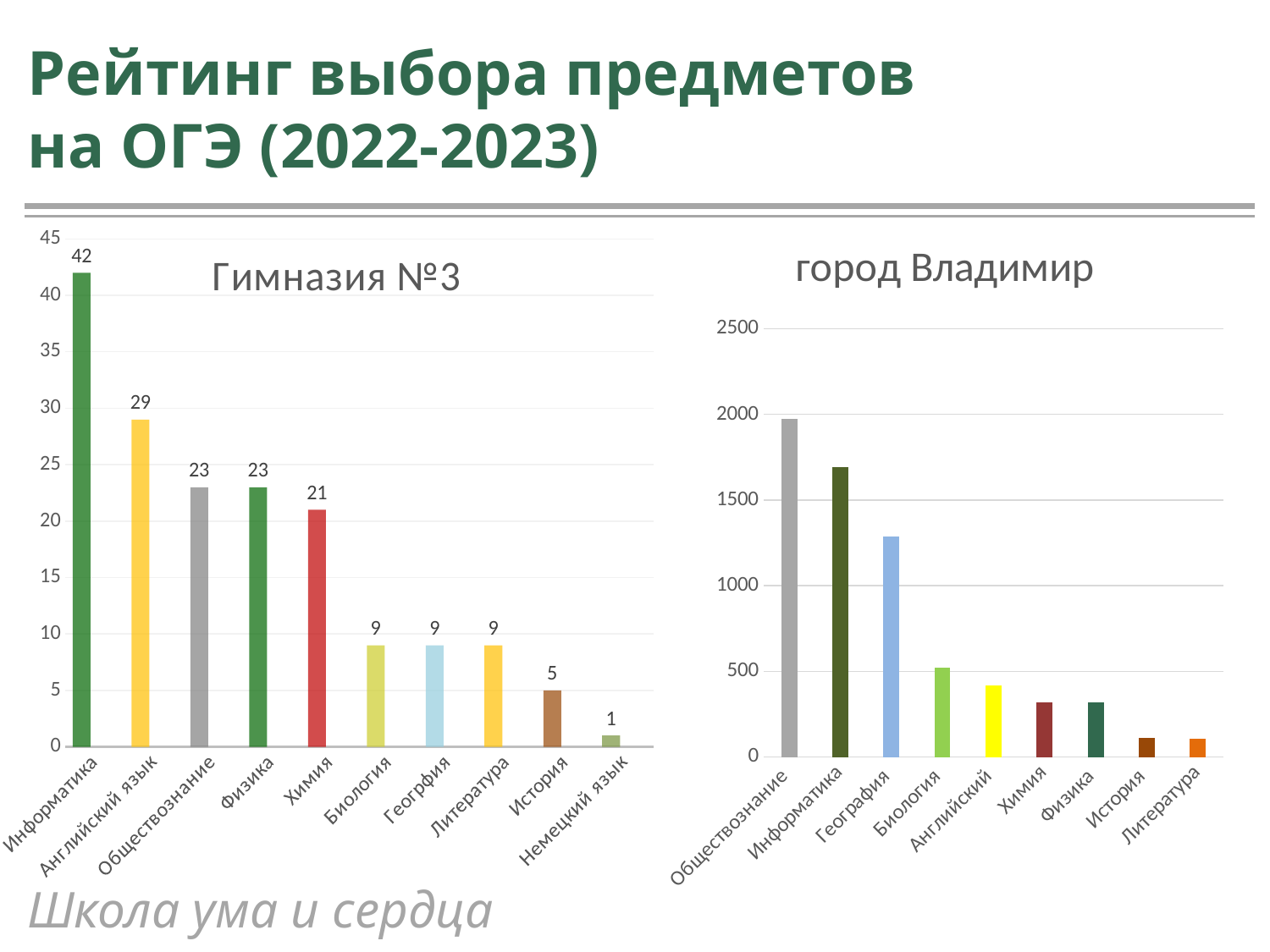
In the 'Гимназия №3' chart, which is larger, История or Литература? Литература In the 'город Владимир' chart, how many subjects are shown? 9 In the 'город Владимир' chart, is the value for Информатика greater or less than 1500? greater In the 'Гимназия №3' chart, which subject has the highest value? Информатика In the 'Гимназия №3' chart, what is the difference between Информатика and Английский язык? 13 In the 'Гимназия №3' chart, what is the value for Химия? 21 In the 'город Владимир' chart, is the value for География greater or less than 1500? less In the 'Гимназия №3' chart, what is the value for Информатика? 42 In the 'Гимназия №3' chart, which subject has the lowest value? Немецкий язык In the 'Гимназия №3' chart, how many subjects are shown? 10 What type of chart is the 'город Владимир' chart? bar chart In the 'город Владимир' chart, which subject has the highest value? Обществознание